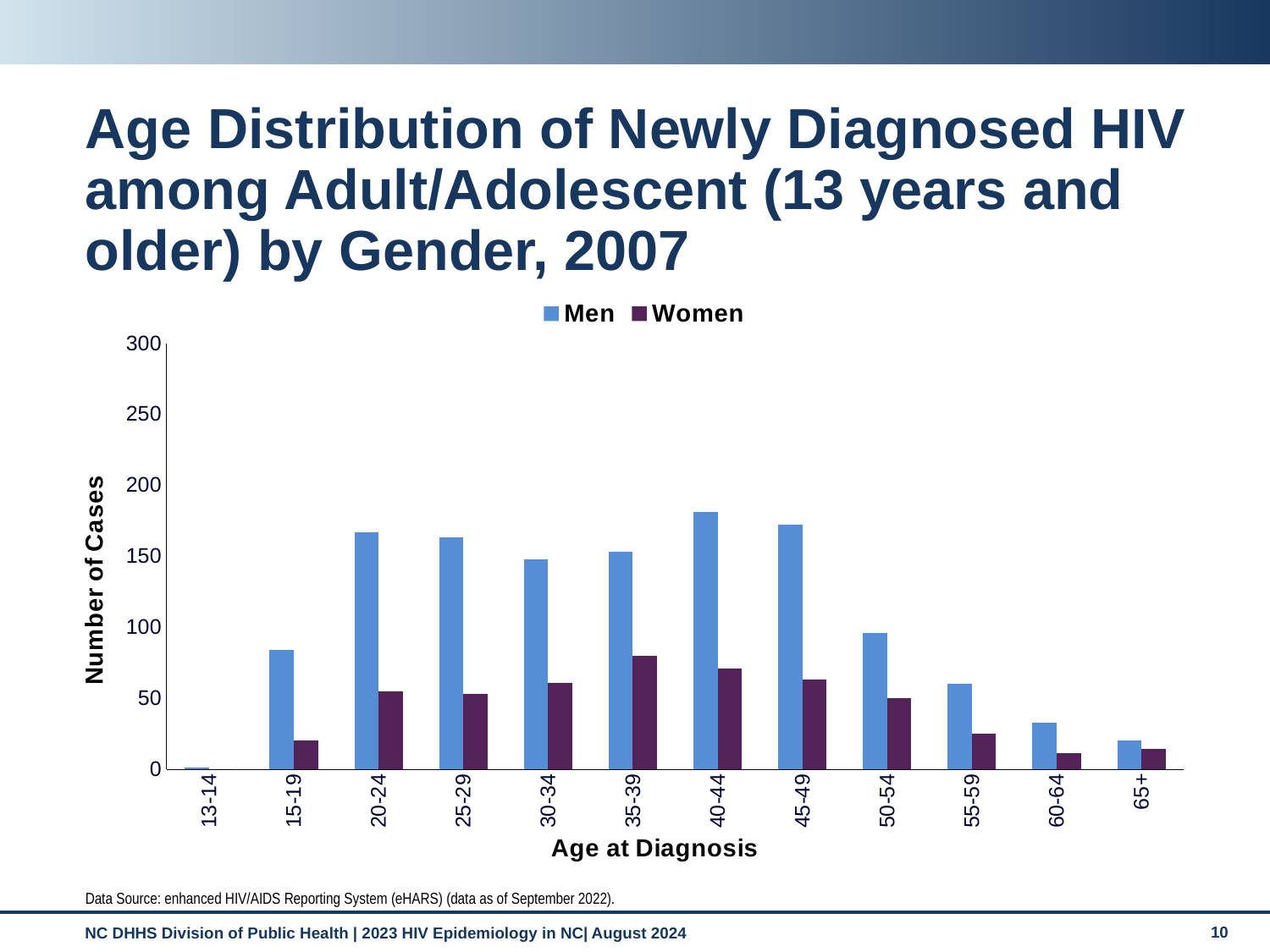
Which age group has the highest number of cases for Men? 40-44 What is the title of the x axis? Age at Diagnosis Is the value for Men in the 40-44 age group greater or less than 150? greater Do the values for Men rise or fall across the age groups from 45-49 to 65+? fall Is the value for Women in the 35-39 age group greater or less than 50? greater What kind of chart is shown on the slide? bar chart Which age group has the lowest number of cases for Men? 13-14 How many series does the legend list? 2 Which is larger: the number of cases for Men aged 20-24 or for Men aged 50-54? Men aged 20-24 Which age group has the highest number of cases for Women? 35-39 How many age groups are shown on the x axis? 12 Is the value for Men in the 50-54 age group greater or less than 100? less